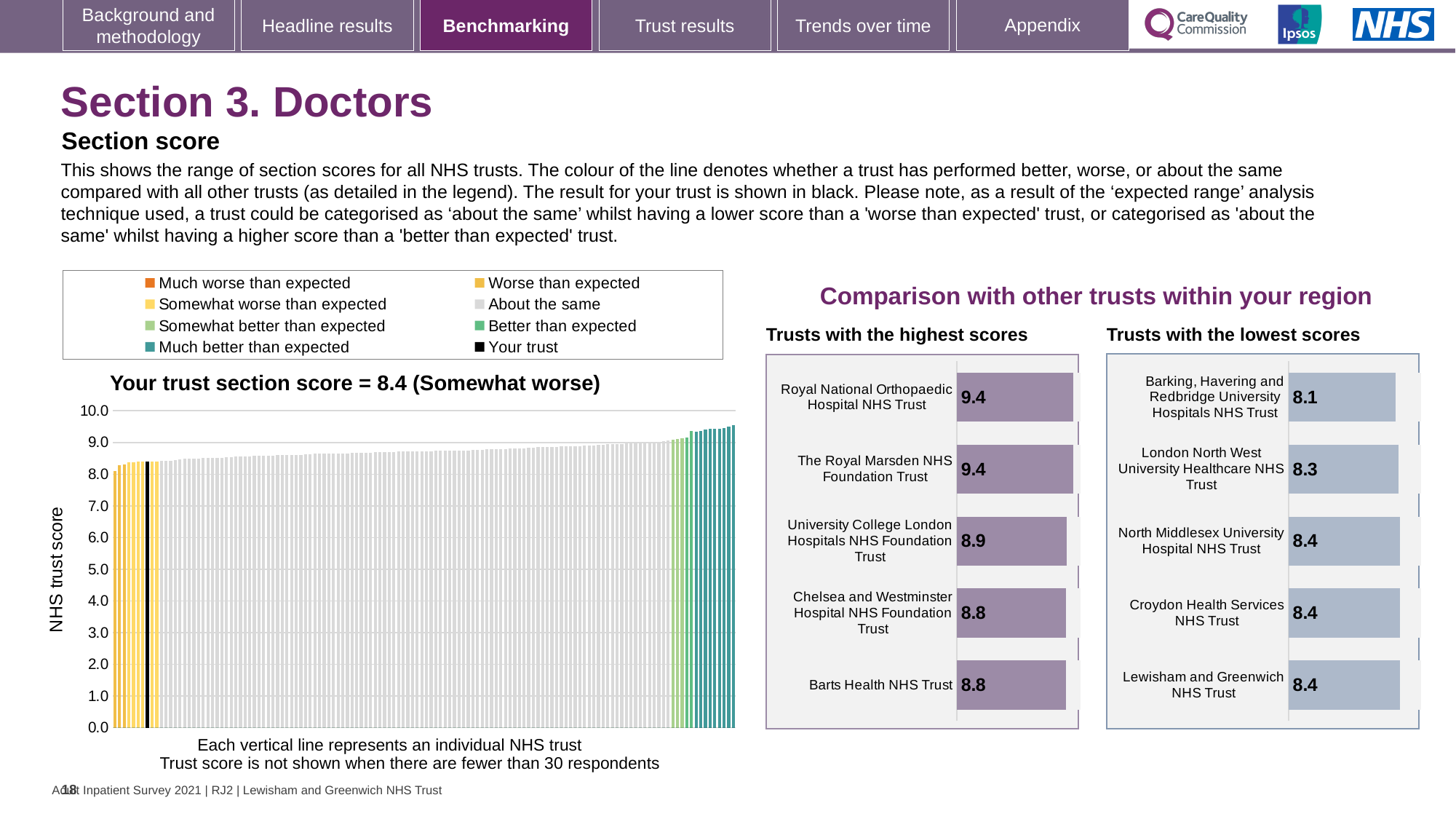
In the 'Trusts with the lowest scores' chart, which trust has the lowest score? Barking, Havering and Redbridge University Hospitals NHS Trust In the main section score chart on the left, do the trust scores rise or fall from left to right along the x axis? Rise In the main section score chart on the left, what is the section score for your trust? 8.4 In the 'Trusts with the highest scores' chart, what is the difference between the score for The Royal Marsden NHS Foundation Trust and the score for Barts Health NHS Trust? 0.6 In the 'Trusts with the lowest scores' chart, what is the score for Barking, Havering and Redbridge University Hospitals NHS Trust? 8.1 How many entries does the legend above the main section score chart list? 8 In the 'Trusts with the highest scores' chart, what is the score for Barts Health NHS Trust? 8.8 What kind of chart is the main section score chart on the left? Bar chart In the 'Trusts with the highest scores' chart, what is the score for University College London Hospitals NHS Foundation Trust? 8.9 In the 'Trusts with the lowest scores' chart, what is the difference between the score for Lewisham and Greenwich NHS Trust and the score for Barking, Havering and Redbridge University Hospitals NHS Trust? 0.3 In the 'Trusts with the lowest scores' chart, which has the higher score: London North West University Healthcare NHS Trust or Barking, Havering and Redbridge University Hospitals NHS Trust? London North West University Healthcare NHS Trust How many trusts are shown in the 'Trusts with the highest scores' chart? 5